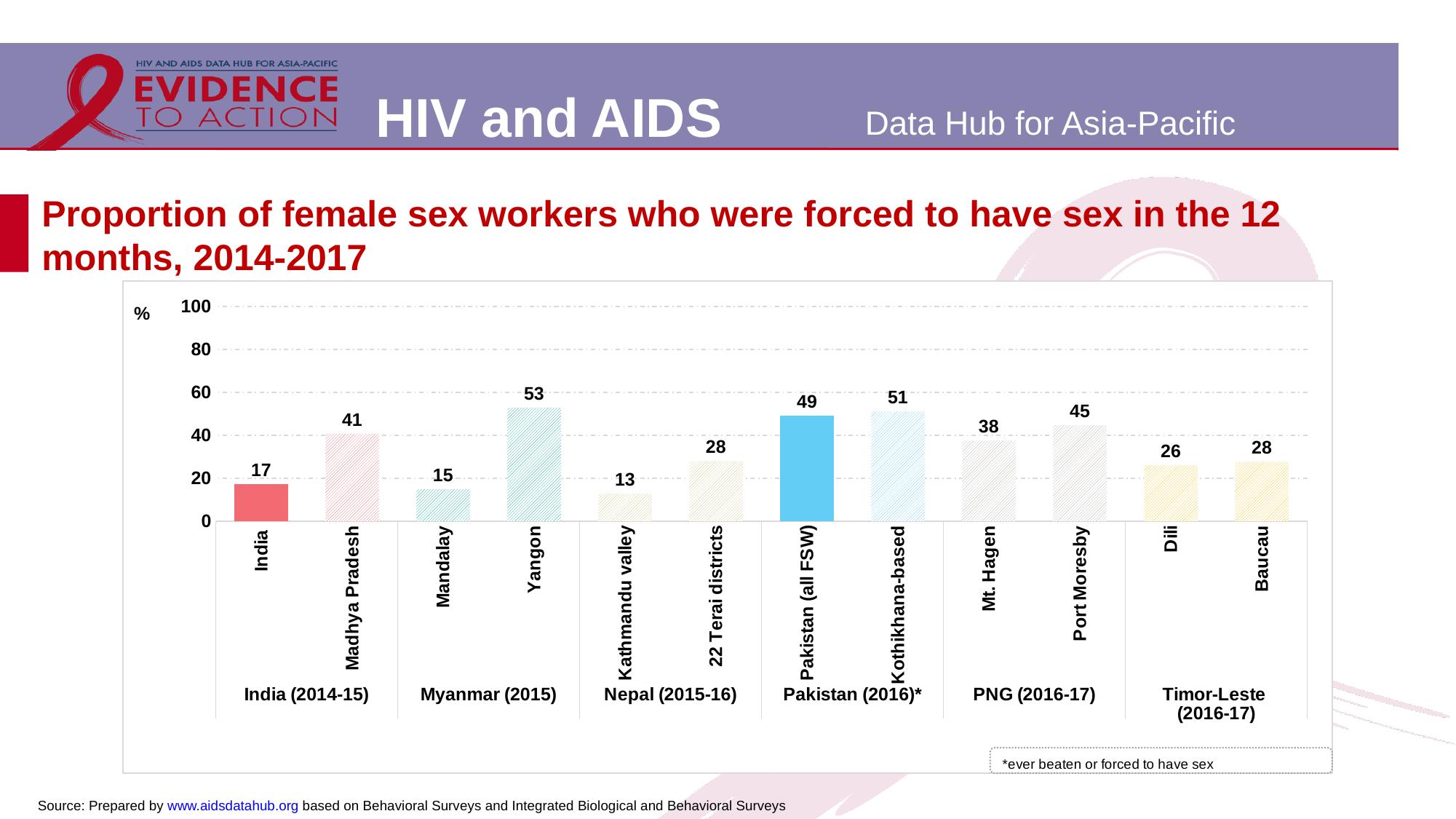
Is the value for Pakistan (all FSW) greater or less than 40? greater What is the value for Kathmandu valley? 13 Which category has the lowest value? Kathmandu valley What does the asterisk on Pakistan (2016)* refer to, according to the note on the chart? ever beaten or forced to have sex What kind of chart is shown on the slide? bar chart Which category has the highest value? Yangon Which is larger, the value for Mt. Hagen or the value for Port Moresby? Port Moresby What is the difference between the values for Madhya Pradesh and India? 24 How many bars are plotted on the chart? 12 What is the value for Dili? 26 What is the value for Yangon? 53 What is the value for Port Moresby? 45